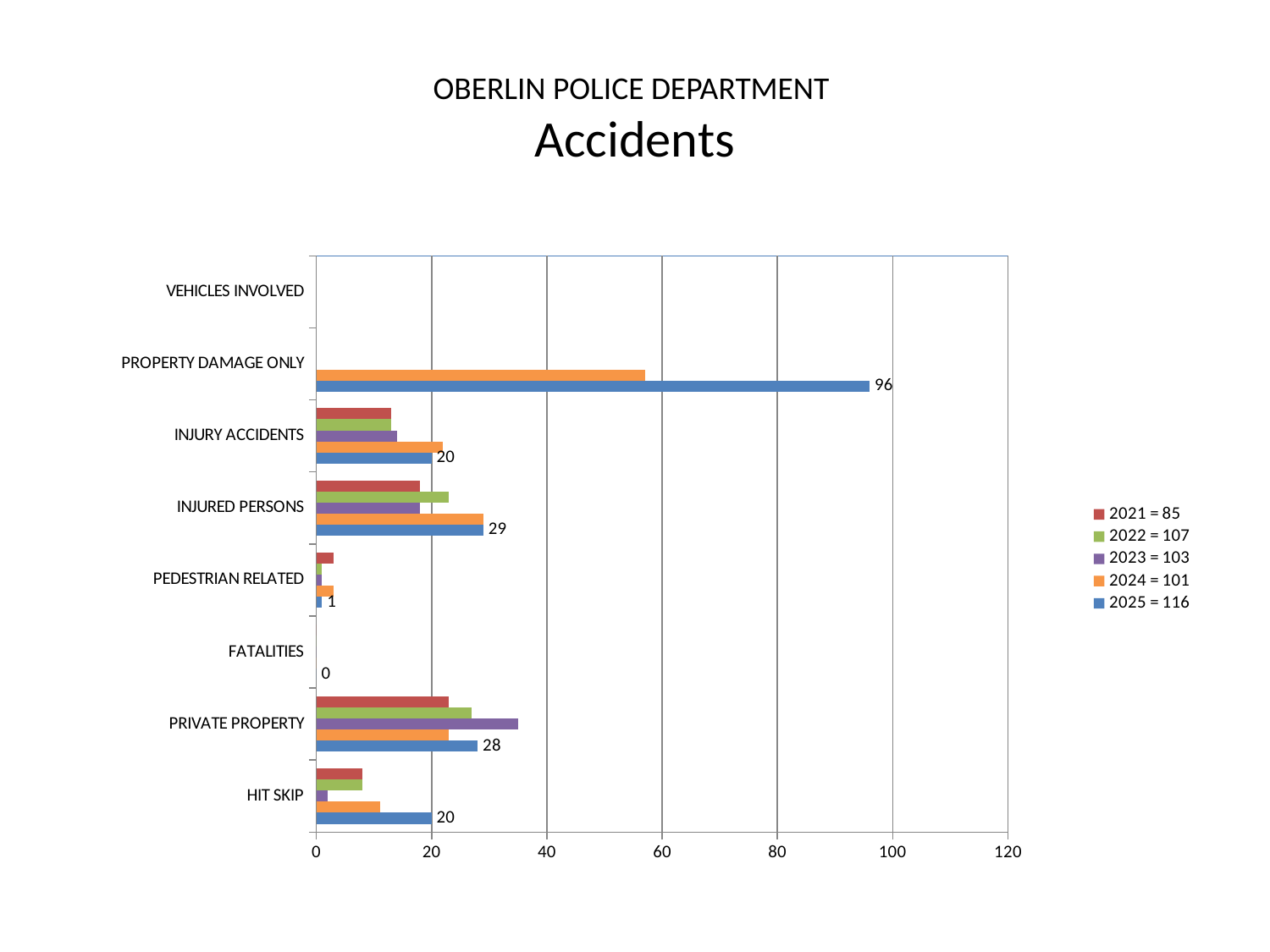
How many series does the legend list? 5 What is the value for PROPERTY DAMAGE ONLY in the 2025 series? 96 Is the 2023 value for PRIVATE PROPERTY greater or less than 30? greater What is the value for FATALITIES in the 2025 series? 0 What is the difference between the 2025 values for PROPERTY DAMAGE ONLY and INJURED PERSONS? 67 Which category has the highest value in the 2025 series? PROPERTY DAMAGE ONLY How many categories are shown on the chart? 8 In the 2025 series, which is larger: PRIVATE PROPERTY or HIT SKIP? PRIVATE PROPERTY Is the 2024 value for PROPERTY DAMAGE ONLY greater or less than 40? greater What is the value for INJURED PERSONS in the 2025 series? 29 What is the value for HIT SKIP in the 2025 series? 20 What kind of chart is shown on the slide? bar chart